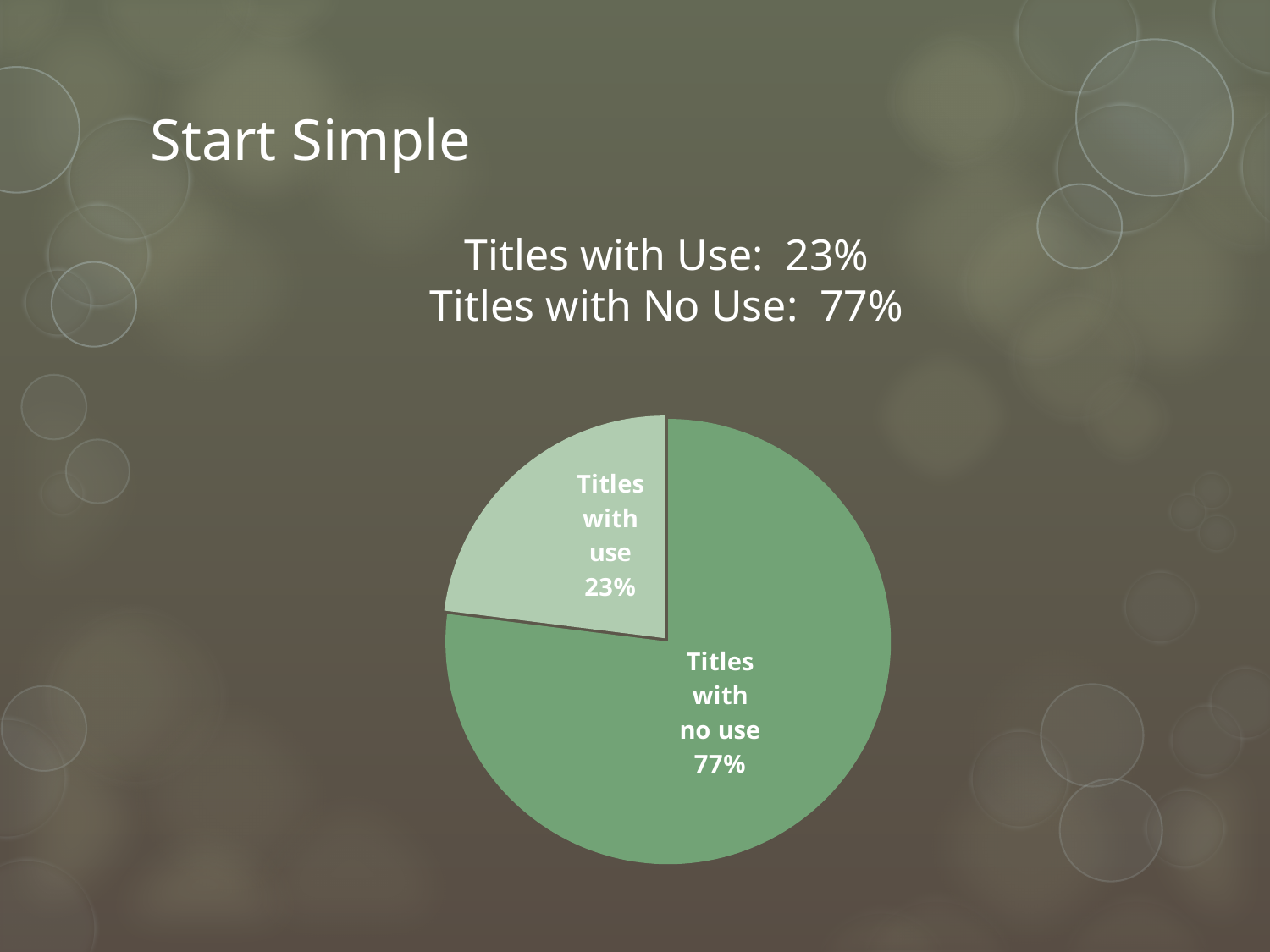
Which slice of the pie chart is shown in the lighter green colour? Titles with use What kind of chart is shown on the slide? Pie chart What is the difference in percentage points between the "Titles with no use" slice and the "Titles with use" slice? 54 percentage points What is the title of the slide containing the pie chart? Start Simple Which slice of the pie chart is the smallest? Titles with use Which is larger: the "Titles with use" slice or the "Titles with no use" slice? Titles with no use What share of the pie is labelled "Titles with use"? 23% How many slices does the pie chart have? 2 What share of the pie is labelled "Titles with no use"? 77% Is the share for "Titles with use" greater or less than 50%? less Which slice of the pie chart is the largest? Titles with no use